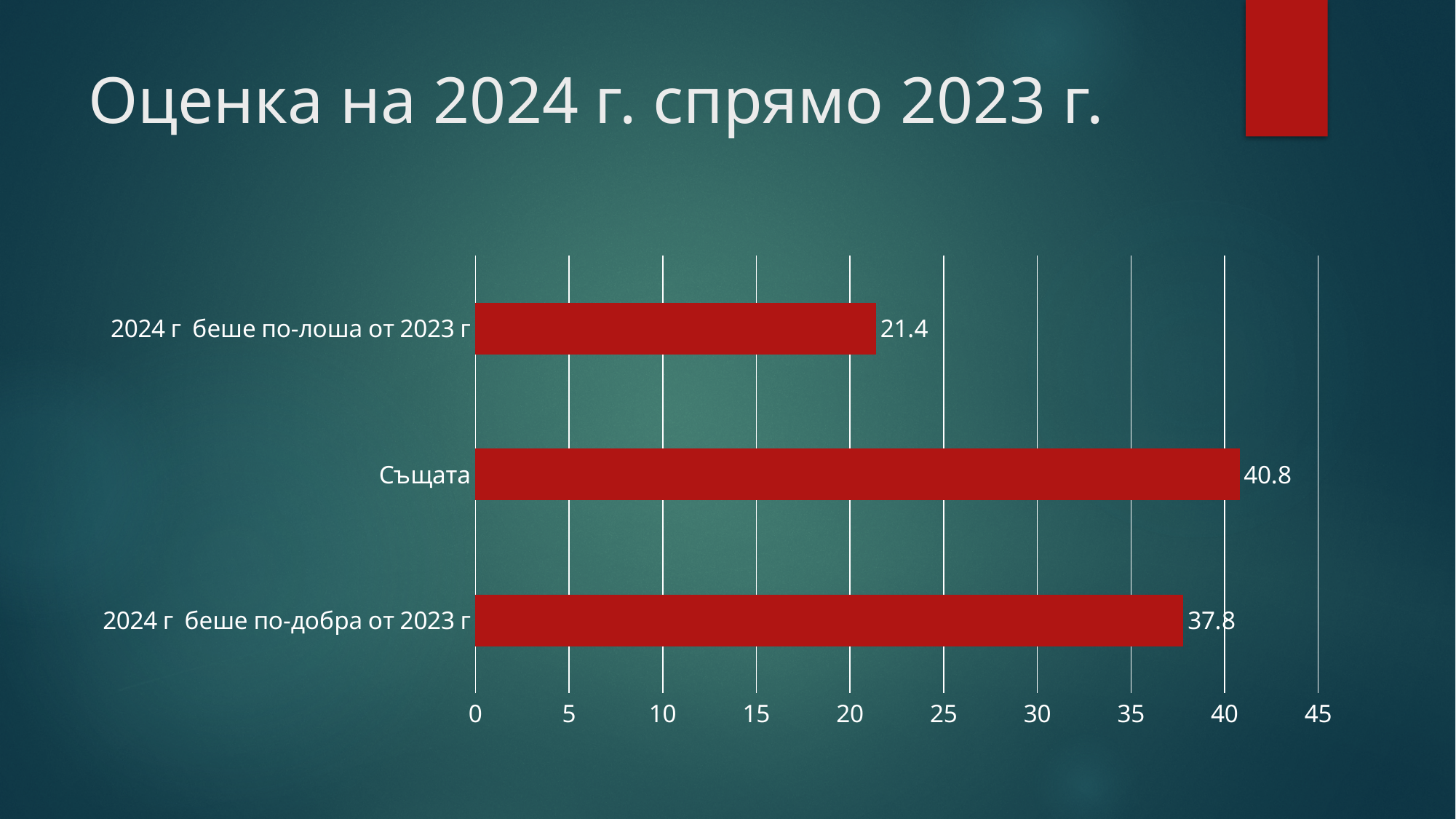
Is the value for "2024 г беше по-лоша от 2023 г" greater or less than 25? less What is the value for "2024 г беше по-добра от 2023 г"? 37.8 What is the value for "2024 г беше по-лоша от 2023 г"? 21.4 What is the difference between the values for "2024 г беше по-добра от 2023 г" and "2024 г беше по-лоша от 2023 г"? 16.4 What kind of chart is shown on the slide? bar chart Which category has the highest value? Същата How many categories are shown in the chart? 3 Which is larger: the value for "Същата" or the value for "2024 г беше по-лоша от 2023 г"? Същата What is the difference between the values for "Същата" and "2024 г беше по-добра от 2023 г"? 3.0 What is the value for "Същата"? 40.8 Which category has the lowest value? 2024 г беше по-лоша от 2023 г What is the title of the slide? Оценка на 2024 г. спрямо 2023 г.